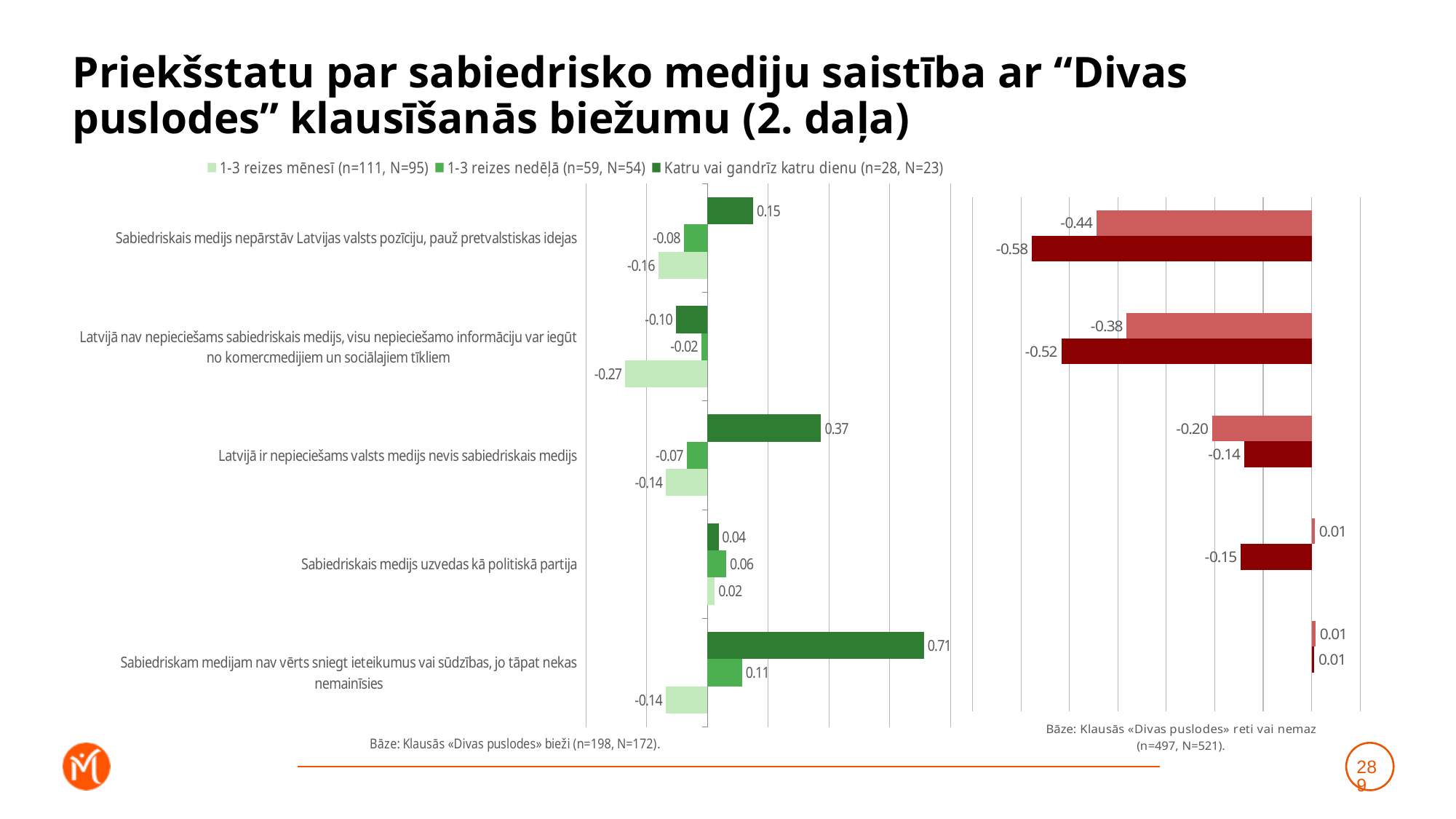
How many series does the legend of the left (green) chart list? 3 In the right (red) chart, what is the dark red value for the statement "Sabiedriskais medijs nepārstāv Latvijas valsts pozīciju, pauž pretvalstiskas idejas"? -0.58 In the left (green) chart, for the statement "Sabiedriskais medijs nepārstāv Latvijas valsts pozīciju, pauž pretvalstiskas idejas", which is larger: the "1-3 reizes nedēļā" value or the "1-3 reizes mēnesī" value? 1-3 reizes nedēļā What base (Bāze) is stated below the right (red) chart? Klausās «Divas puslodes» reti vai nemaz (n=497, N=521) In the left (green) chart, what is the value for "1-3 reizes mēnesī" for the statement "Latvijā nav nepieciešams sabiedriskais medijs, visu nepieciešamo informāciju var iegūt no komercmedijiem un sociālajiem tīkliem"? -0.27 What kind of chart is the left (green) chart? Bar chart In the left (green) chart, what is the value for "Katru vai gandrīz katru dienu" for the statement "Sabiedriskam medijam nav vērts sniegt ieteikumus vai sūdzības, jo tāpat nekas nemainīsies"? 0.71 In the left (green) chart, what is the value for "1-3 reizes nedēļā" for the statement "Sabiedriskais medijs uzvedas kā politiskā partija"? 0.06 How many statements (categories) are shown in the left (green) chart? 5 In the left (green) chart, which statement has the highest value for "Katru vai gandrīz katru dienu"? Sabiedriskam medijam nav vērts sniegt ieteikumus vai sūdzības, jo tāpat nekas nemainīsies In the left (green) chart, which statement has the lowest value for "1-3 reizes mēnesī"? Latvijā nav nepieciešams sabiedriskais medijs, visu nepieciešamo informāciju var iegūt no komercmedijiem un sociālajiem tīkliem In the left (green) chart, what is the difference between the "Katru vai gandrīz katru dienu" value and the "1-3 reizes mēnesī" value for the statement "Latvijā ir nepieciešams valsts medijs nevis sabiedriskais medijs"? 0.51